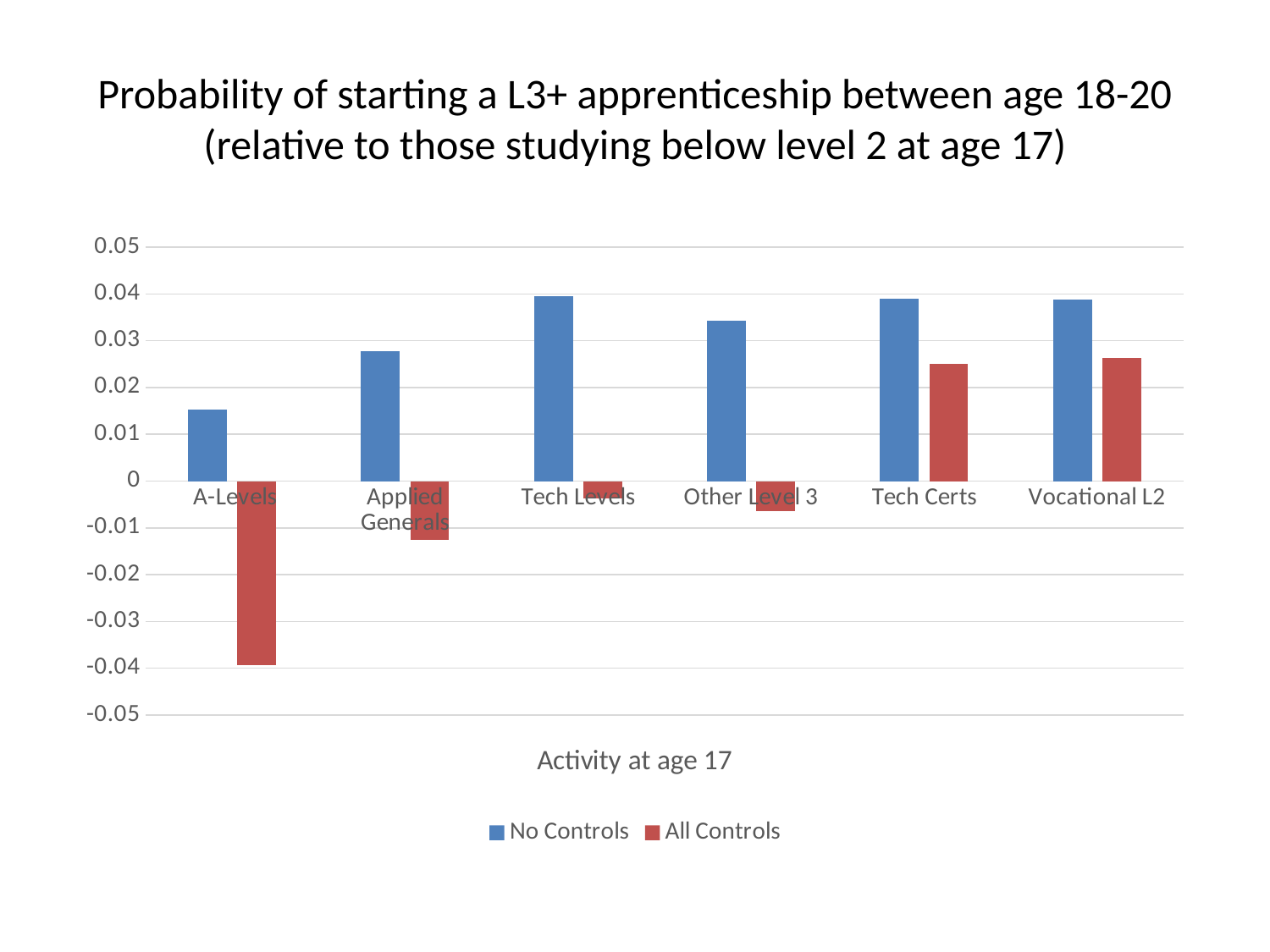
What kind of chart is shown on the slide? bar chart How many series does the legend list? 2 Which category has the lowest All Controls value? A-Levels Is the All Controls value for A-Levels greater or less than -0.03? less What is the title of the x axis? Activity at age 17 Is the No Controls value for A-Levels greater or less than 0.02? less Which series is shown in red? All Controls Is the All Controls value for Tech Certs greater or less than 0.02? greater How many categories are shown on the x axis? 6 Which has the larger No Controls value, A-Levels or Applied Generals? Applied Generals Which category has the lowest No Controls value? A-Levels